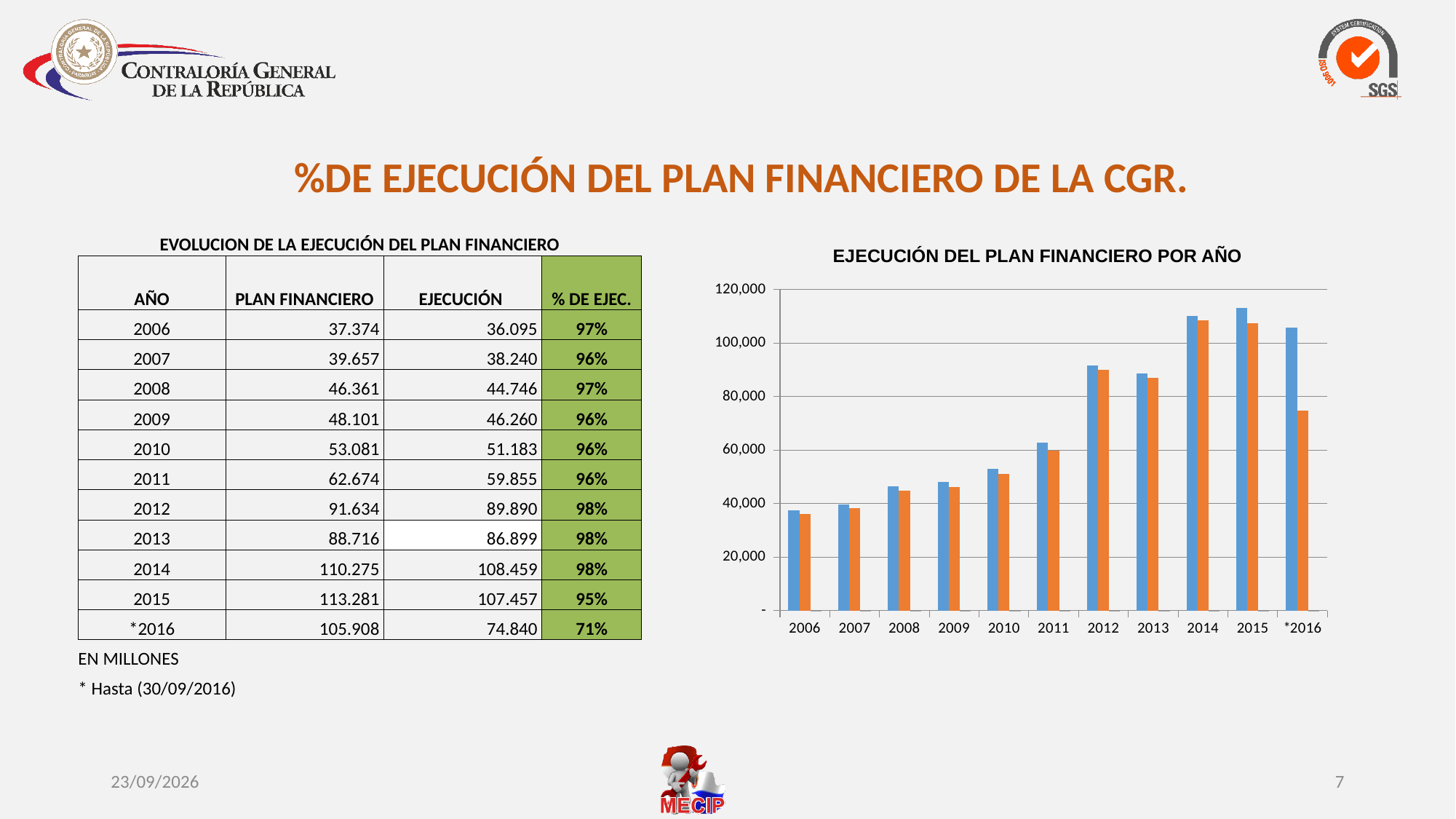
How many years are shown on the x axis of the chart 'EJECUCIÓN DEL PLAN FINANCIERO POR AÑO'? 11 In the chart 'EJECUCIÓN DEL PLAN FINANCIERO POR AÑO', for *2016, which bar is taller, the blue one or the orange one? the blue one In the chart 'EJECUCIÓN DEL PLAN FINANCIERO POR AÑO', is the orange bar for *2016 greater or less than 80,000? less In the chart 'EJECUCIÓN DEL PLAN FINANCIERO POR AÑO', is the blue bar for 2006 greater or less than 40,000? less In the chart 'EJECUCIÓN DEL PLAN FINANCIERO POR AÑO', is the blue bar for 2015 greater or less than 100,000? greater What is the title of the chart on the right side of the slide? EJECUCIÓN DEL PLAN FINANCIERO POR AÑO In the chart 'EJECUCIÓN DEL PLAN FINANCIERO POR AÑO', which year has the shortest blue bar? 2006 In the chart 'EJECUCIÓN DEL PLAN FINANCIERO POR AÑO', which year has the tallest blue bar? 2015 What kind of chart is 'EJECUCIÓN DEL PLAN FINANCIERO POR AÑO'? bar chart In the chart 'EJECUCIÓN DEL PLAN FINANCIERO POR AÑO', do the blue bars generally rise or fall from 2006 to 2015? rise In the chart 'EJECUCIÓN DEL PLAN FINANCIERO POR AÑO', how many bars are shown for each year? 2